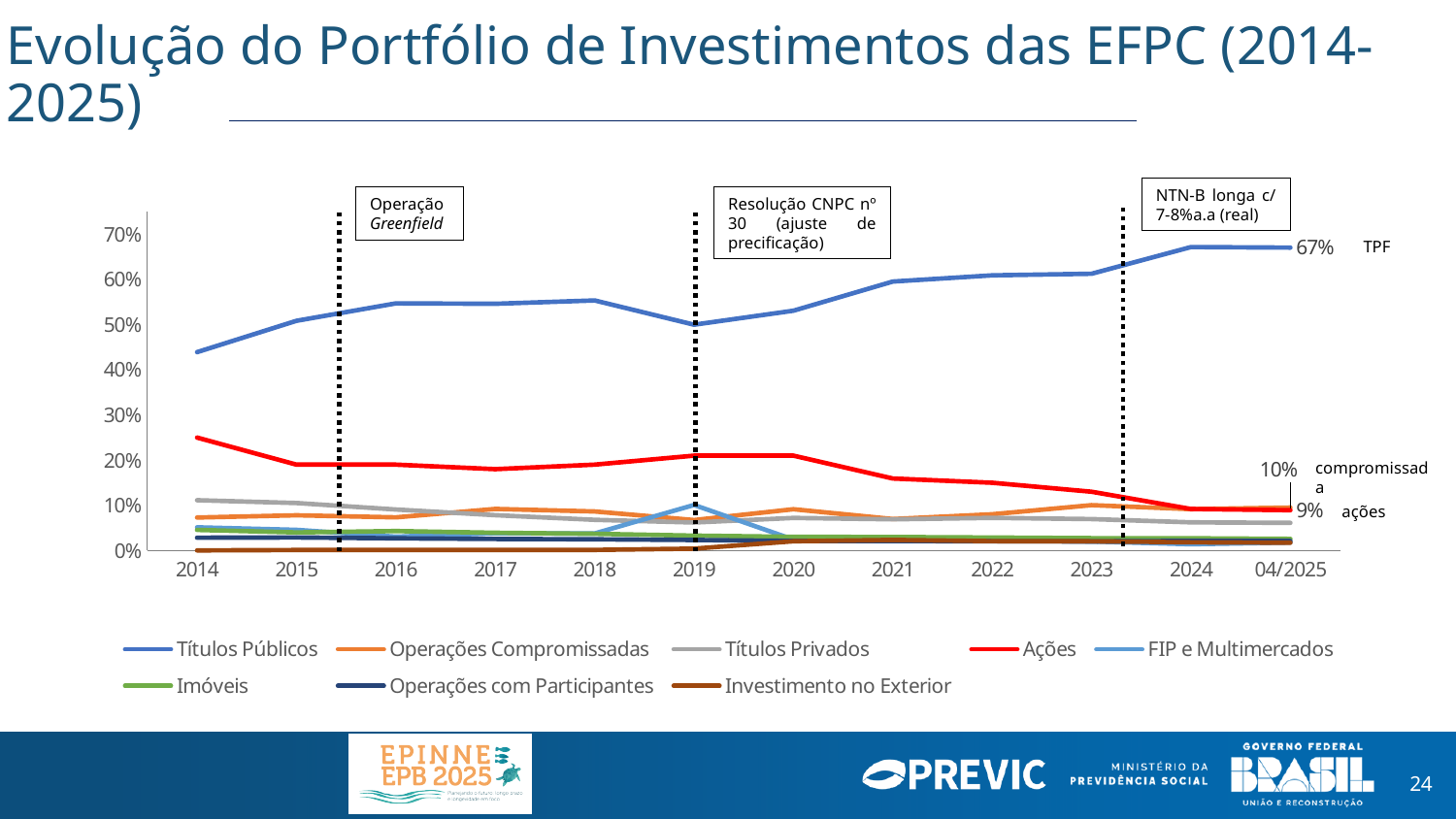
What is the value for Operações Compromissadas at 04/2025? 10% Is the value for Ações in 2014 greater or less than 20%? greater Which series has the highest value at 04/2025? Títulos Públicos What is the value for Títulos Públicos at 04/2025? 67% Does the Títulos Públicos line rise or fall from 2014 to 04/2025? Rise How many series does the legend list? 8 What is the value for Ações at 04/2025? 9% Is the value for Títulos Públicos in 2014 greater or less than 50%? less What kind of chart is shown on the slide? Line chart Does the Ações line rise or fall from 2014 to 04/2025? Fall How many points are shown along the x axis? 12 What is the difference between the Títulos Públicos value and the Ações value at 04/2025? 58 percentage points